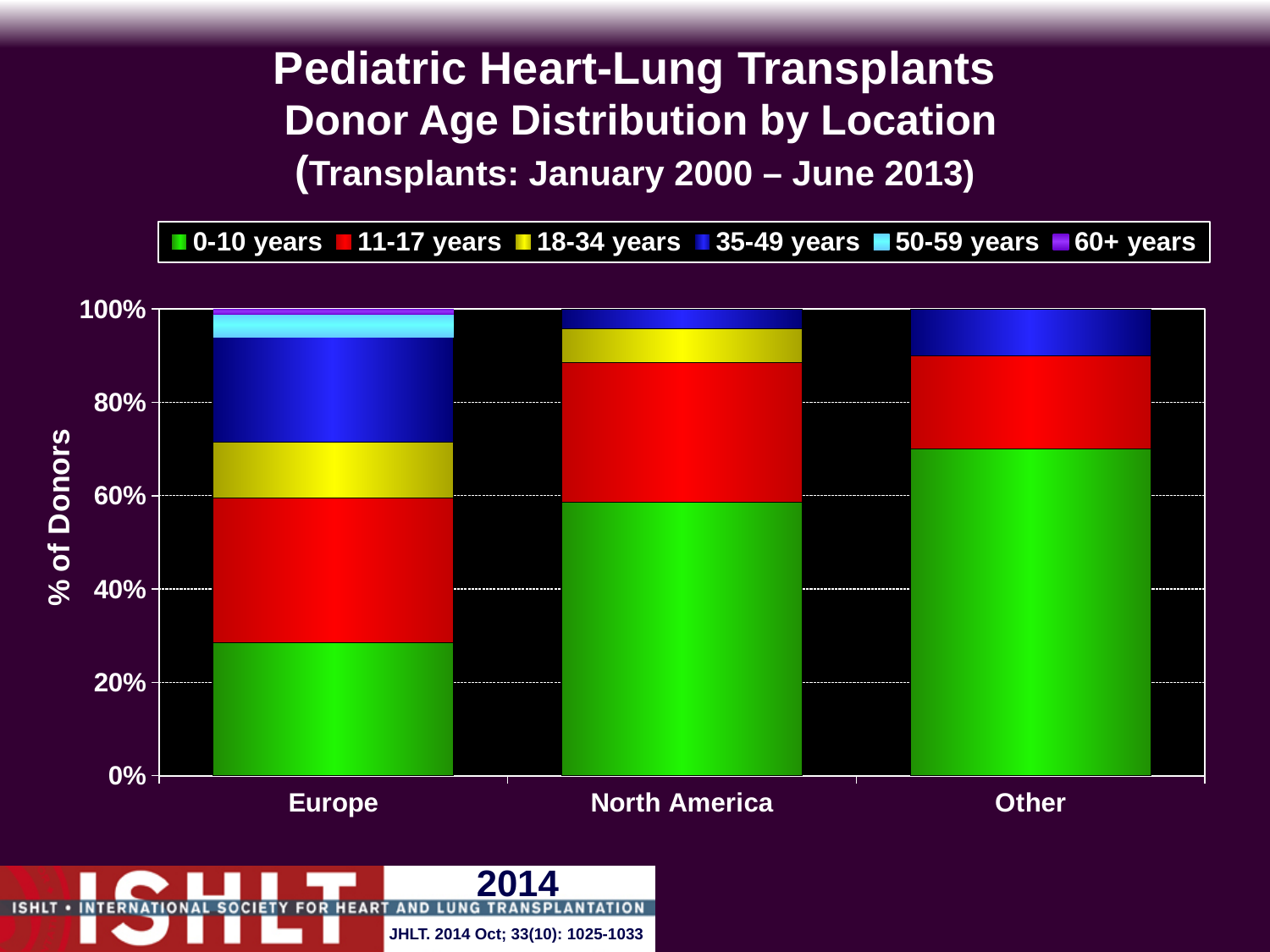
Is the 0-10 years share of donors larger for Europe or for Other? Other Is the 35-49 years share of donors larger for Europe or for North America? Europe Which location is the only one with a visible 50-59 years segment? Europe What kind of chart is shown on the slide? Stacked bar chart Is the 0-10 years share of donors for North America greater or less than 40%? greater Which location has the smallest share of donors aged 0-10 years? Europe How many locations are shown along the x axis? 3 Is the 0-10 years share of donors for Other greater or less than 60%? greater What is the label on the y axis? % of Donors How many donor age groups does the legend list? 6 Is the 0-10 years share of donors for Europe greater or less than 40%? less Which location has the largest share of donors aged 0-10 years? Other